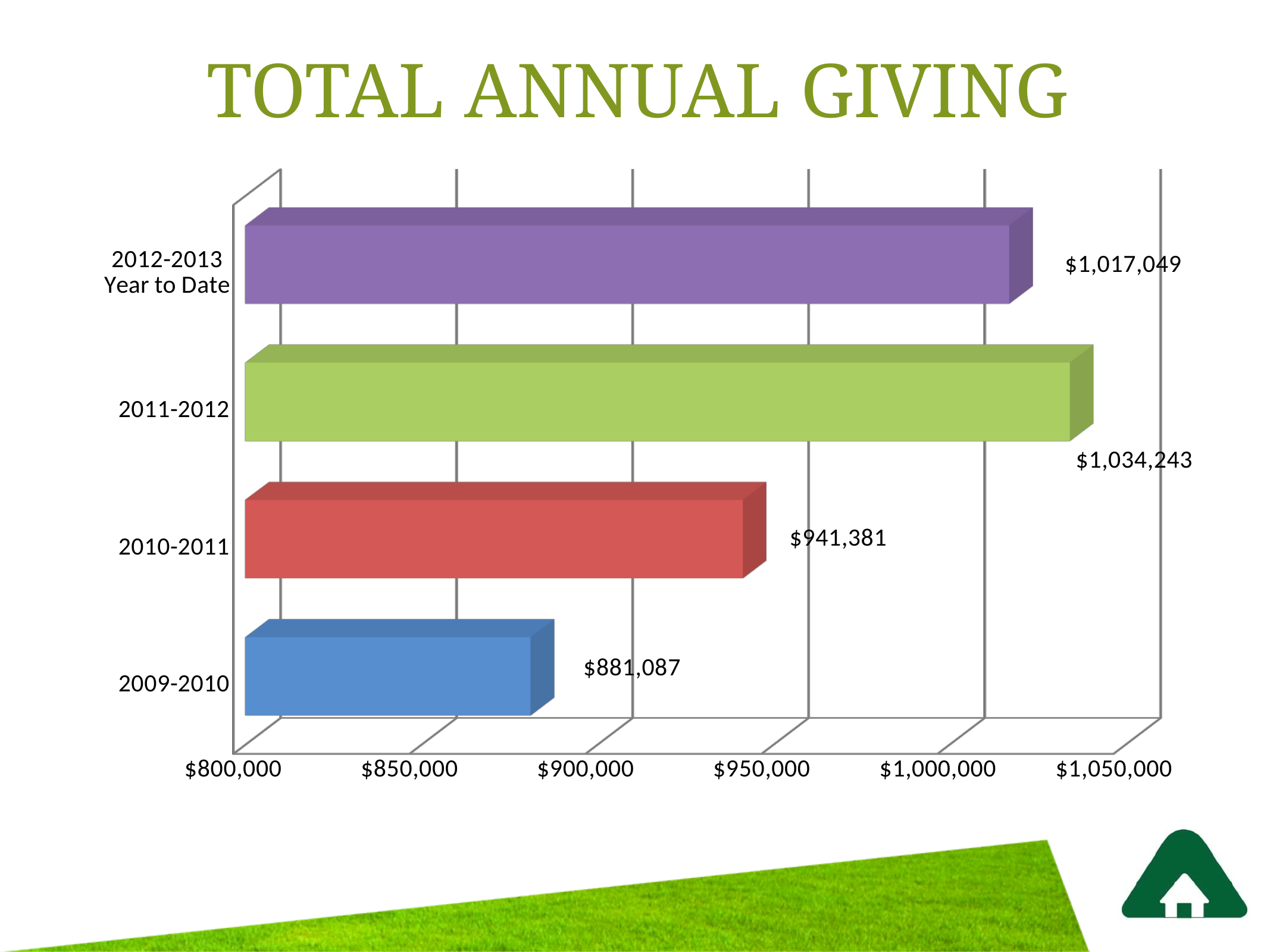
What kind of chart is shown on the slide? Bar chart Which period has the lowest total annual giving? 2009-2010 How many periods are shown in the chart? 4 Which period has the highest total annual giving? 2011-2012 What is the total annual giving for 2012-2013 Year to Date? $1,017,049 What is the difference in giving between 2011-2012 and 2012-2013 Year to Date? $17,194 What is the difference in giving between 2010-2011 and 2009-2010? $60,294 What is the total annual giving for 2010-2011? $941,381 What is the title of the chart? TOTAL ANNUAL GIVING What is the total annual giving for 2009-2010? $881,087 What is the total annual giving for 2011-2012? $1,034,243 Which is larger, the giving for 2010-2011 or for 2012-2013 Year to Date? 2012-2013 Year to Date